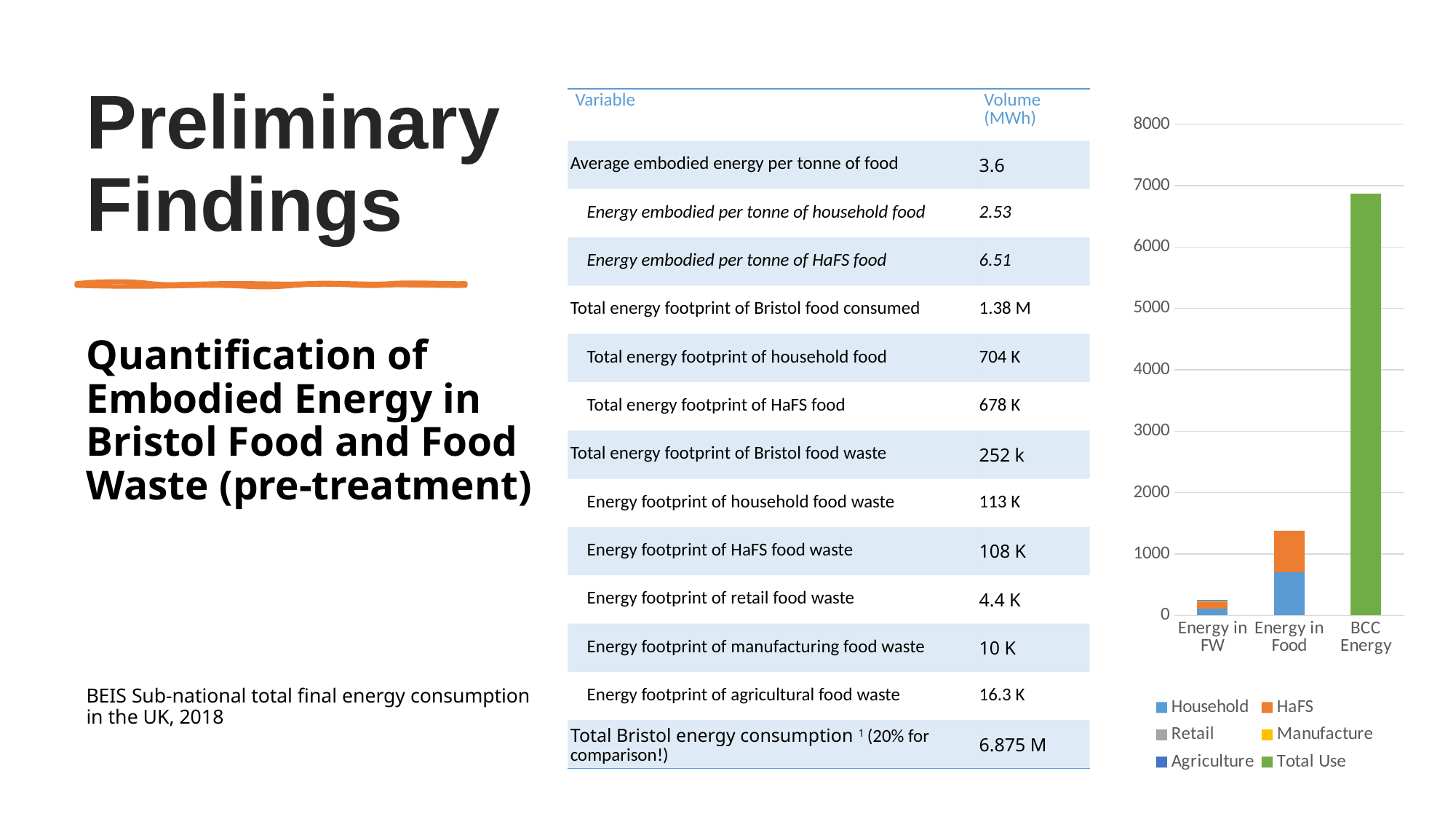
How many series does the legend of the bar chart list? 6 Which category has the shortest bar in the chart? Energy in FW Is the total value for Energy in Food greater or less than 1000? greater Is the total value for Energy in FW greater or less than 1000? less Is the total value for Energy in Food greater or less than 2000? less Which category has the tallest bar in the chart? BCC Energy Do the bar heights rise or fall from left to right across the x axis? rise How many categories are shown on the x axis of the bar chart? 3 What colour represents the Total Use series in the chart legend? green What kind of chart is shown on the right of the slide? stacked bar chart Which is larger, the bar for Energy in Food or the bar for Energy in FW? Energy in Food